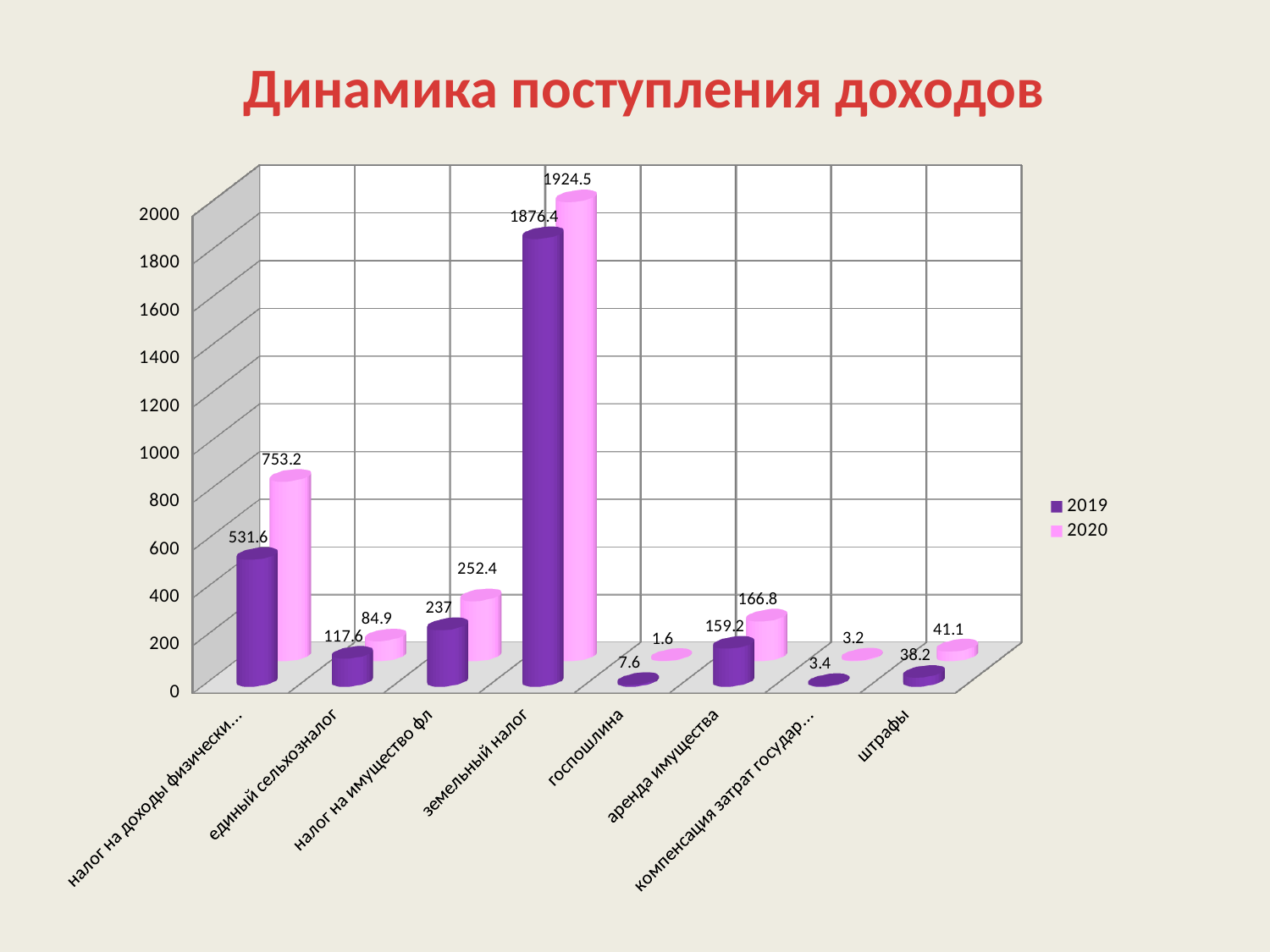
How many categories are shown on the x axis? 8 What is the 2020 value for штрафы? 41.1 What is the 2020 value for земельный налог? 1924.5 Which category has the lowest 2020 value? госпошлина Which category has the highest 2019 value? земельный налог What is the 2019 value for единый сельхозналог? 117.6 By how much did земельный налог increase from 2019 to 2020? 48.1 What is the difference between the 2019 and 2020 values for госпошлина? 6 Is the 2020 value for аренда имущества greater or less than 200? less For единый сельхозналог, which year has the larger value, 2019 or 2020? 2019 How many series does the legend list? 2 What type of chart is shown on the slide? bar chart